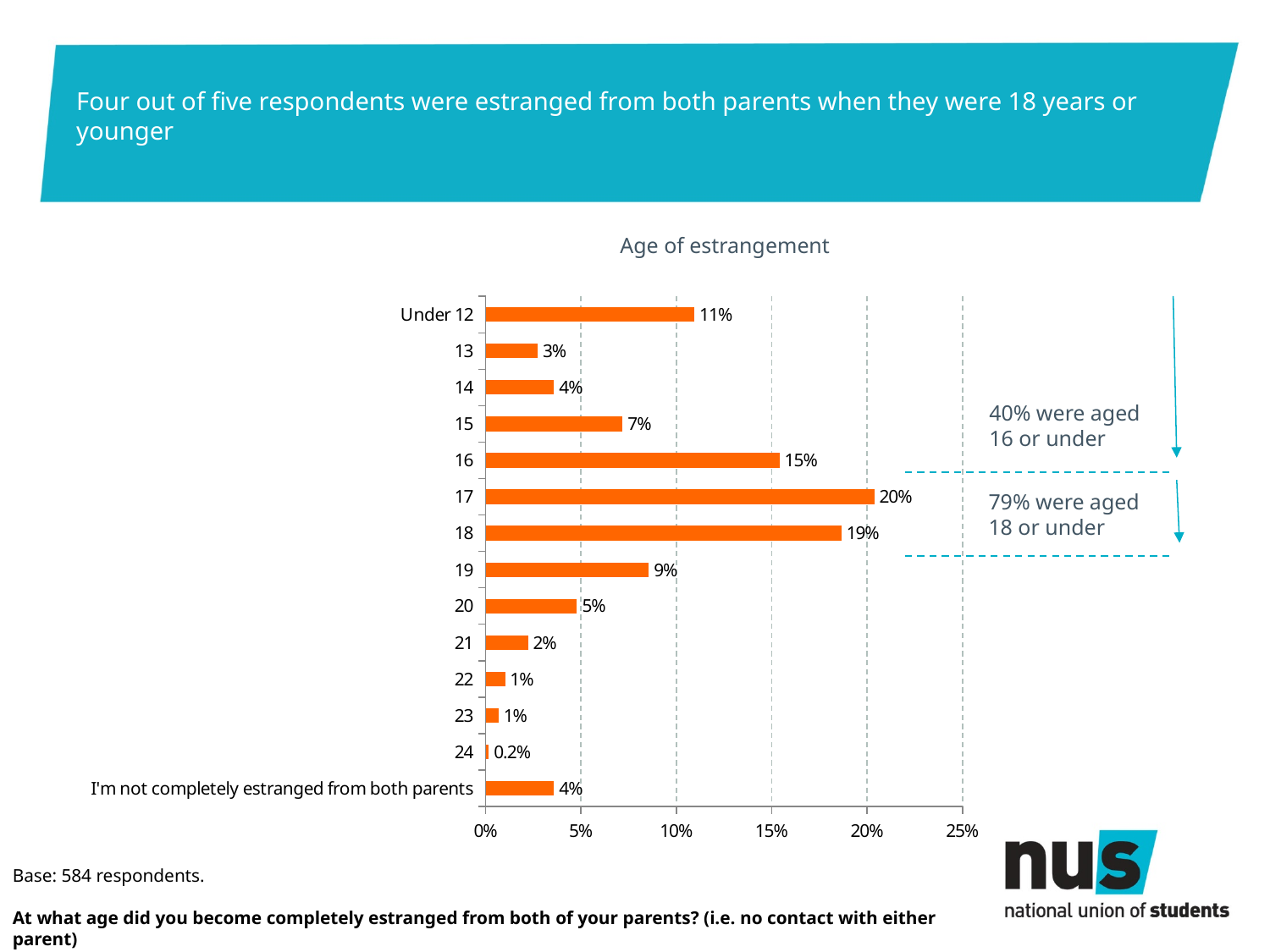
Which is larger, the value for age 18 or the value for age 19? 18 Is the value for age 16 greater or less than 10%? greater Which age category has the highest value? 17 What is the value for age 24? 0.2% What is the value for age 17? 20% What is the title of the chart? Age of estrangement What kind of chart is shown on the slide? Bar chart Which category has the lowest value? 24 What is the value for Under 12? 11% What is the value for 'I'm not completely estranged from both parents'? 4% What is the difference between the values for age 17 and age 16? 5% How many categories are shown on the chart? 14